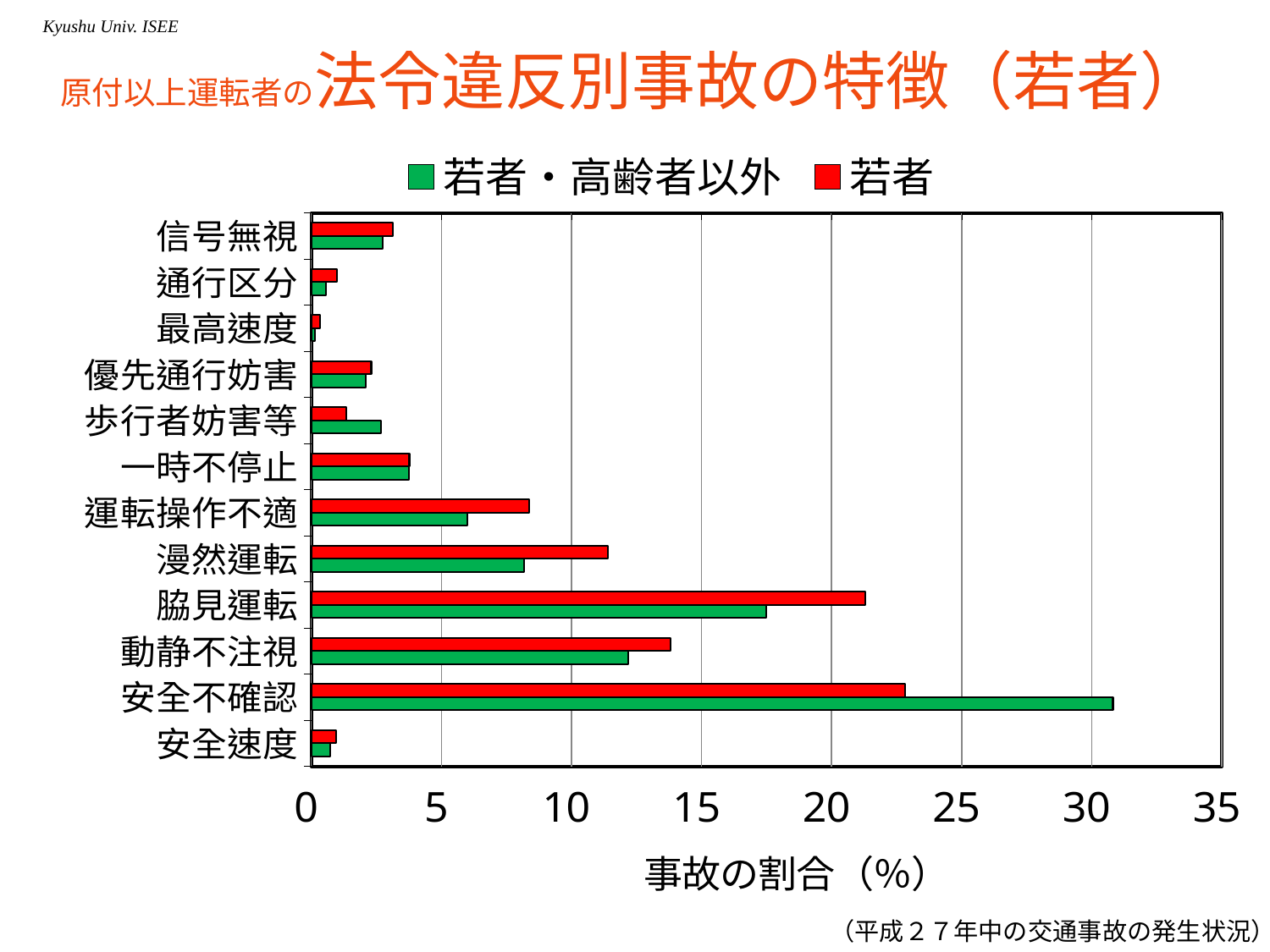
What is the label of the x axis? 事故の割合（%） Is the 若者 value for 脇見運転 greater or less than 20? greater How many series does the legend list? 2 What kind of chart is shown on the slide? bar chart Which category has the highest value for the 若者・高齢者以外 series? 安全不確認 Is the 若者 value for 一時不停止 greater or less than 5? less How many violation categories are plotted on the y axis? 12 Is the 若者 value for 漫然運転 greater or less than 10? greater Which category has the lowest value for the 若者 series? 最高速度 Which category has the highest value for the 若者 series? 安全不確認 For 安全不確認, which series has the larger value, 若者 or 若者・高齢者以外? 若者・高齢者以外